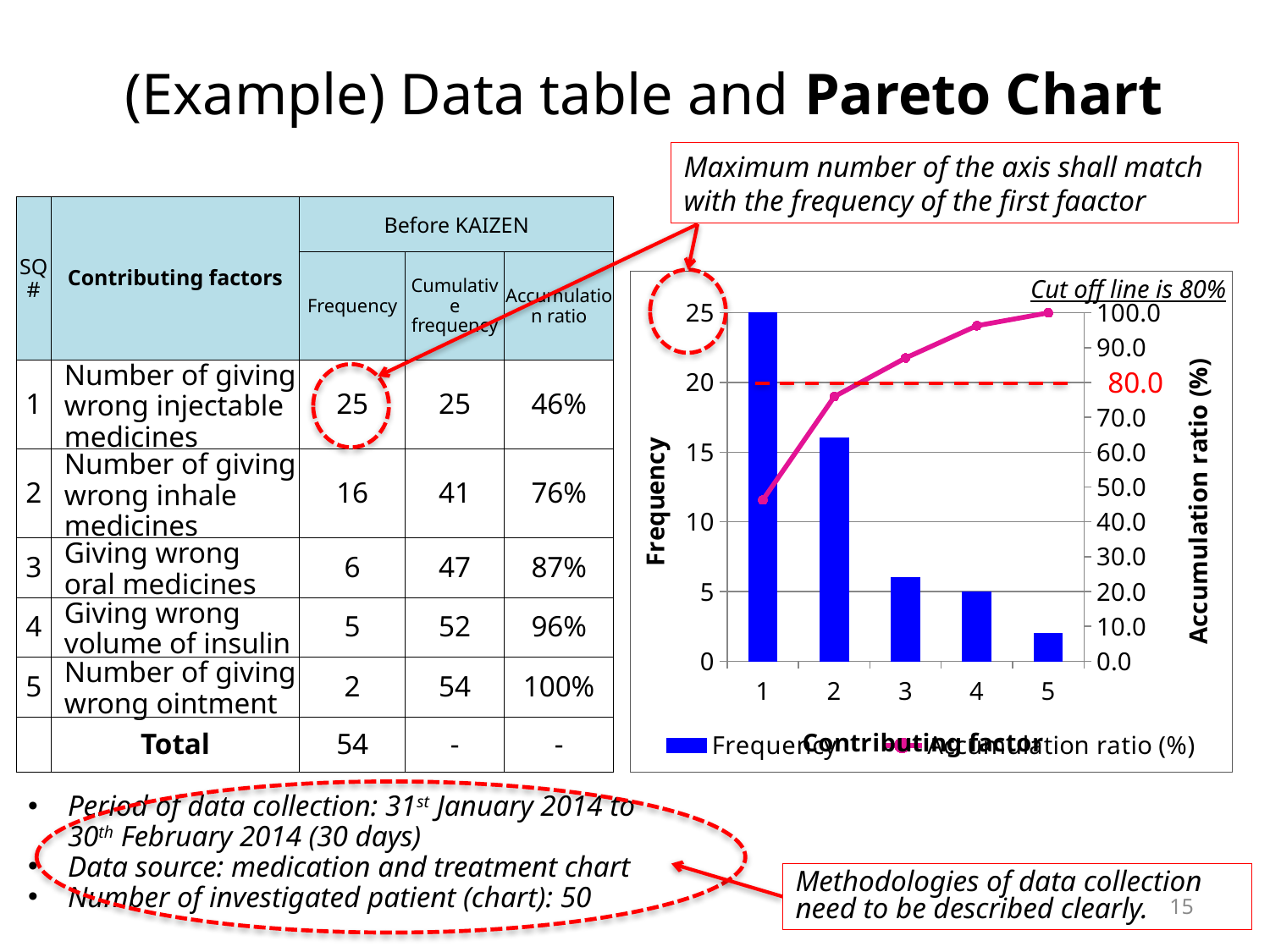
Which contributing factor has the lowest frequency bar? 5 What type of chart is shown on the slide? Pareto chart (bar chart with a line) Which contributing factor has the highest frequency bar? 1 How many contributing factors are plotted on the x axis of the chart? 5 At what accumulation ratio value is the red dashed cut-off line drawn on the chart? 80.0 What is the frequency for contributing factor 1 in the chart? 25 How many series does the chart legend list? 2 What is the difference between the frequency of factor 1 and the frequency of factor 4? 20 Do the frequency bars rise or fall from factor 1 to factor 5? fall Is the frequency for contributing factor 3 greater or less than 10? less What is the frequency for contributing factor 4 in the chart? 5 Is the frequency for contributing factor 2 greater or less than 15? greater